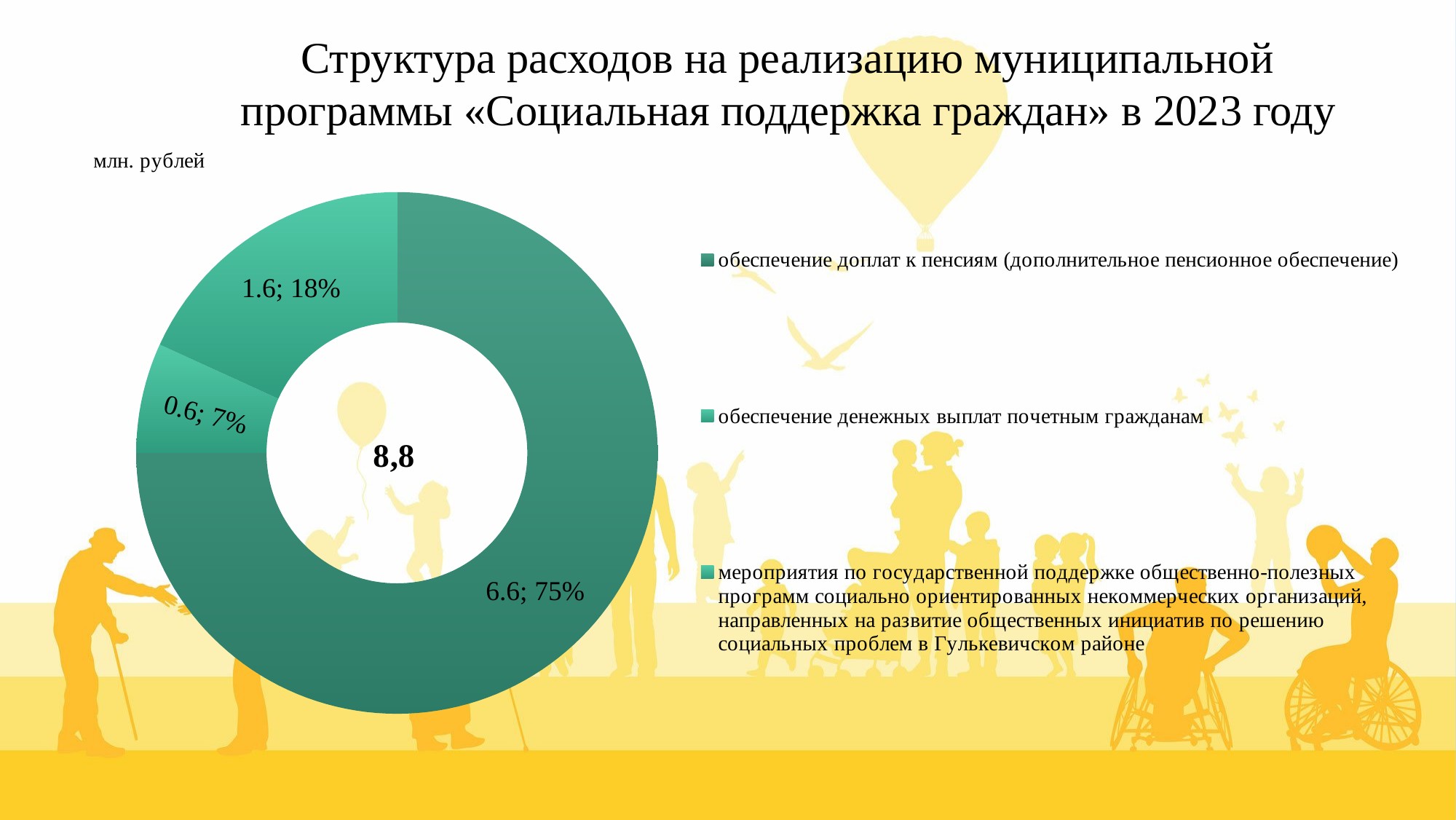
Which category has the largest value? обеспечение доплат к пенсиям (дополнительное пенсионное обеспечение) What share of the total does «обеспечение доплат к пенсиям» account for? 75% What is the value for «обеспечение денежных выплат почетным гражданам»? 0.6 What share of the total does «обеспечение денежных выплат почетным гражданам» account for? 7% What is the value for «обеспечение доплат к пенсиям (дополнительное пенсионное обеспечение)»? 6.6 What share of the total do the measures supporting socially oriented non-profit organisations account for? 18% Which category has the smallest value? обеспечение денежных выплат почетным гражданам What is the value for «мероприятия по государственной поддержке общественно-полезных программ социально ориентированных некоммерческих организаций»? 1.6 What is the difference between the value for «обеспечение доплат к пенсиям» and the value for «обеспечение денежных выплат почетным гражданам»? 6.0 How many categories does the chart show? 3 What kind of chart is shown on the slide? Pie (doughnut) chart What total value is shown in the centre of the chart? 8,8